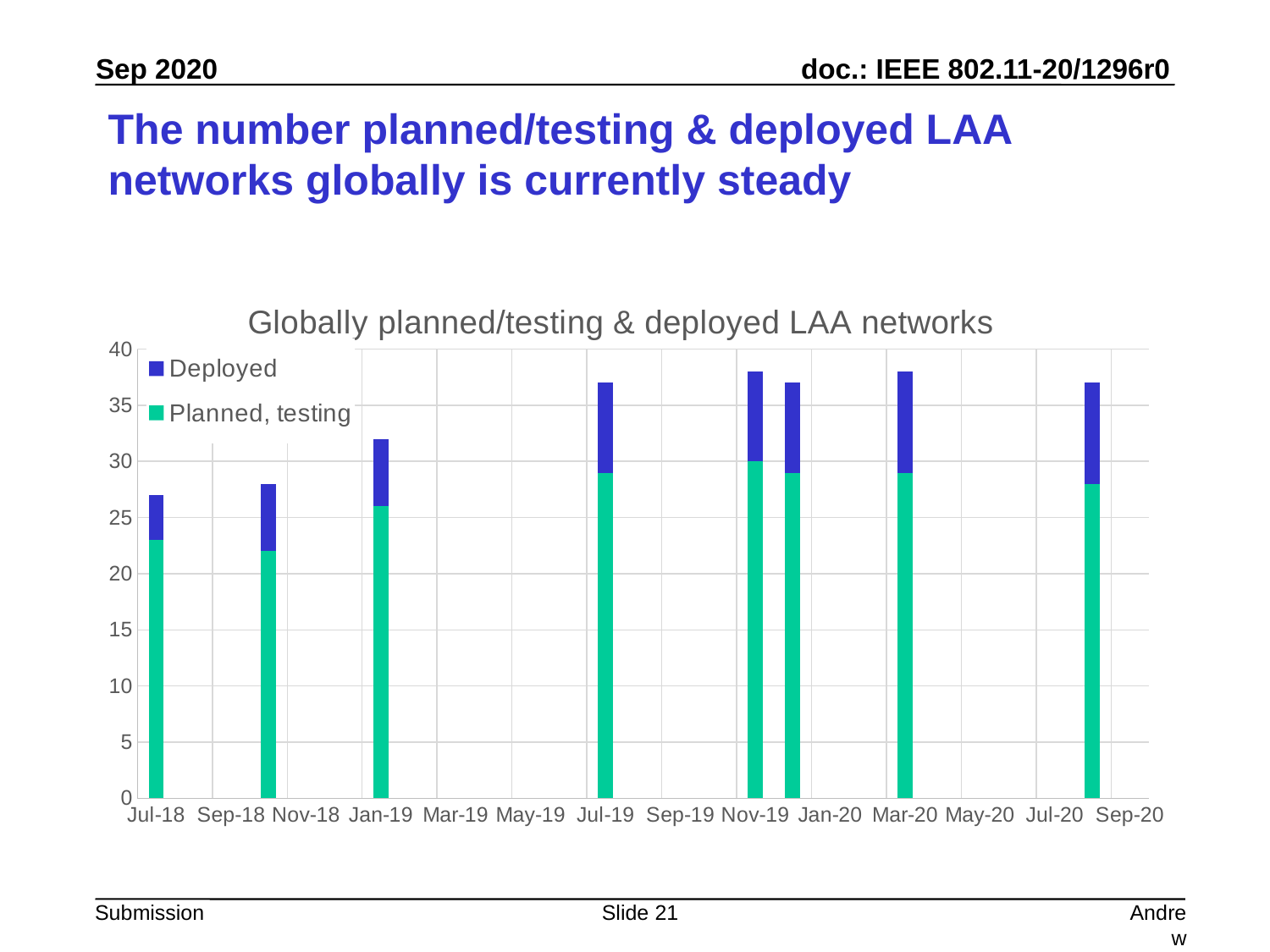
Do the bar totals generally rise or fall from Jul-18 to Sep-20? rise Is the 'Planned, testing' value for Jul-18 greater or less than 25? less Is the total value of the Jul-18 bar greater or less than 30? less What kind of chart is shown on the slide? Stacked bar chart What are the two series named in the legend? Deployed; Planned, testing Is the total value of the Jan-19 bar greater or less than 35? less How many series does the legend list? 2 How many bars are plotted in the chart? 8 Which bar has a larger total, Jan-19 or Jul-19? Jul-19 What is the title of the chart? Globally planned/testing & deployed LAA networks